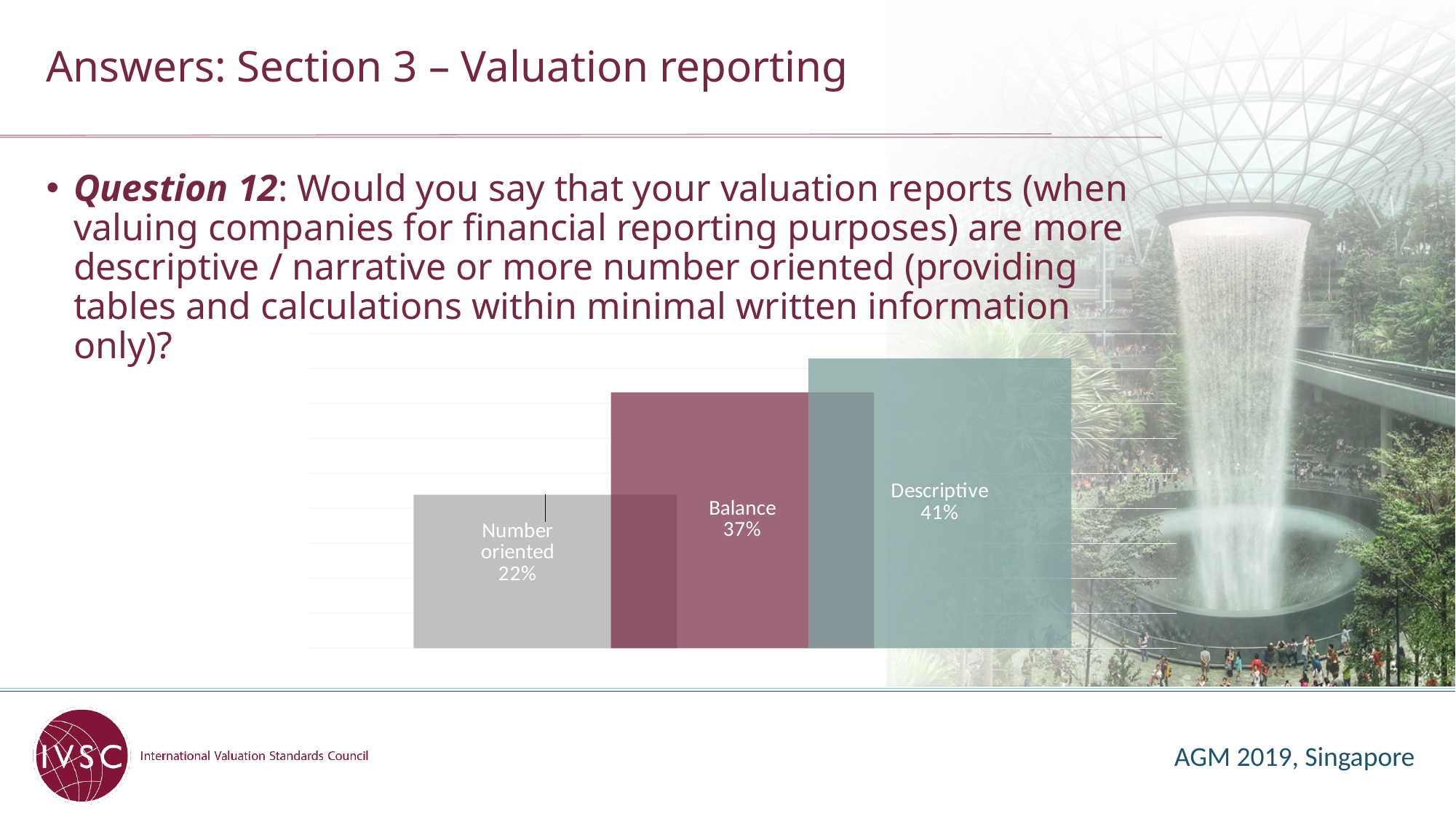
Do the values rise or fall from left to right across the categories? Rise What is the combined percentage of Balance and Descriptive? 78% What percentage of respondents said their valuation reports are descriptive? 41% What is the difference in percentage points between Descriptive and Balance? 4 What is the difference in percentage points between Descriptive and Number oriented? 19 How many categories are shown in the chart? 3 Which is larger, the value for Balance or the value for Number oriented? Balance Which category has the highest percentage? Descriptive What percentage of respondents chose Balance? 37% Which category has the lowest percentage? Number oriented What kind of chart is shown on the slide? Bar chart What percentage of respondents said their valuation reports are number oriented? 22%